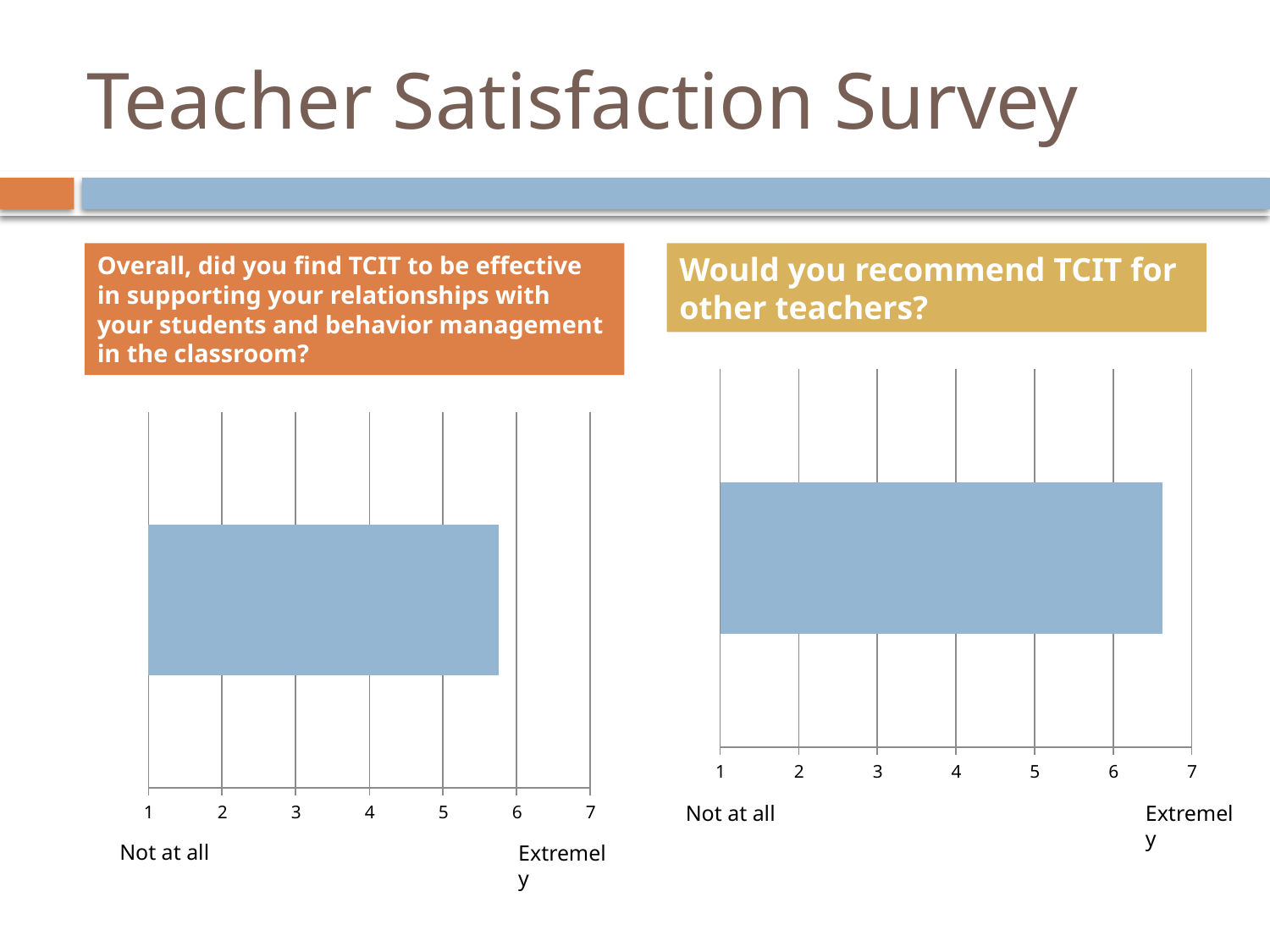
Which chart shows the longer bar: the left chart ("Overall, did you find TCIT to be effective...") or the right chart ("Would you recommend TCIT for other teachers?")? the right chart ("Would you recommend TCIT for other teachers?") In the left chart ("Overall, did you find TCIT to be effective..."), is the bar's value greater or less than 5? greater In the right chart ("Would you recommend TCIT for other teachers?"), is the bar's value greater or less than 7? less How many bars are plotted in the left chart ("Overall, did you find TCIT to be effective...")? 1 What kind of chart is shown under the heading "Overall, did you find TCIT to be effective..." on the left of the slide? bar chart What label appears at the left end of the x axis in the left chart ("Overall, did you find TCIT to be effective...")? Not at all What is the highest value shown on the x axis of the right chart ("Would you recommend TCIT for other teachers?")? 7 In the right chart ("Would you recommend TCIT for other teachers?"), is the bar's value greater or less than 6? greater How many bars are plotted in the right chart ("Would you recommend TCIT for other teachers?")? 1 What kind of chart is shown under the heading "Would you recommend TCIT for other teachers?"? bar chart